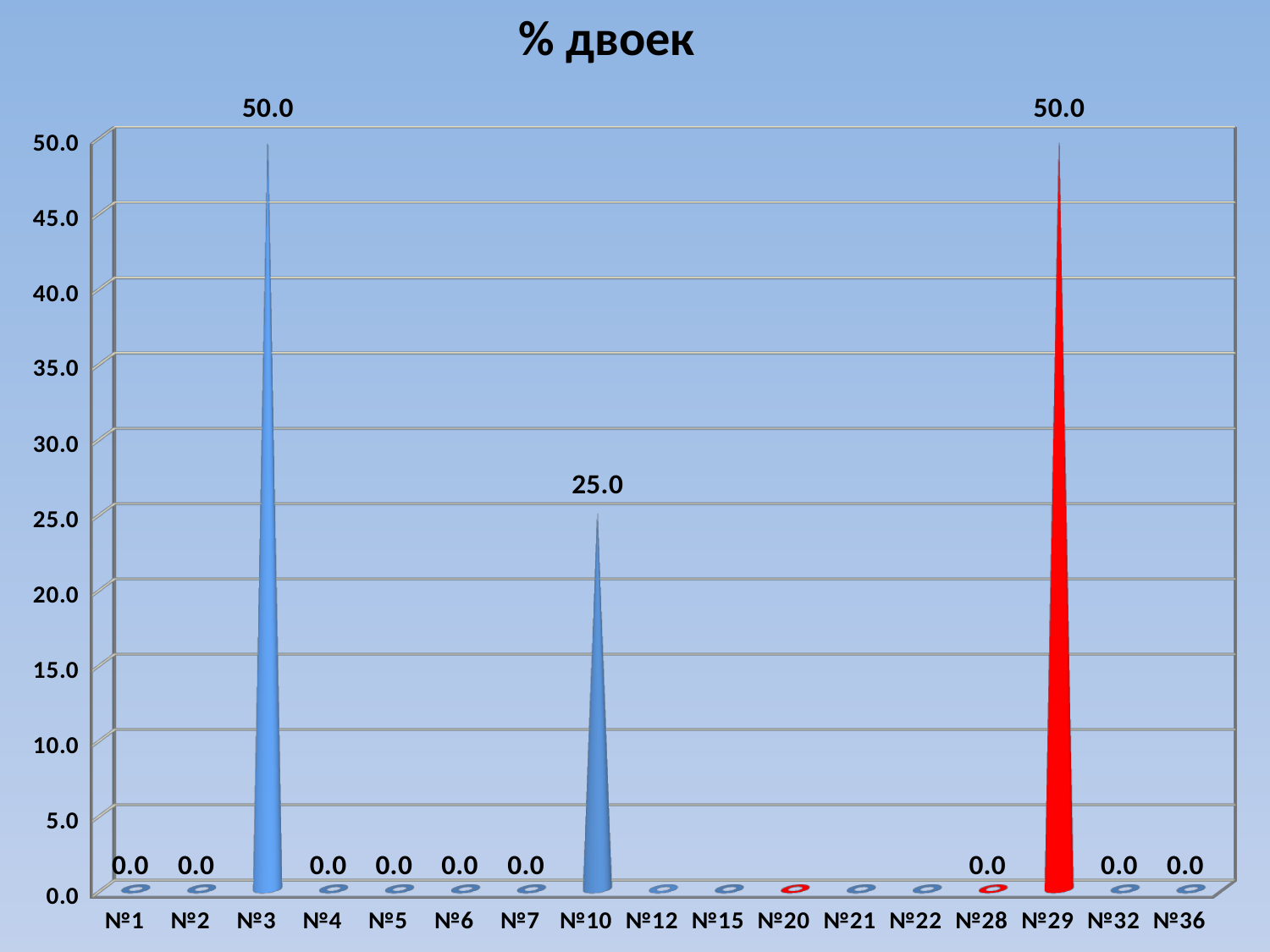
What is the value for №10? 25.0 What kind of chart is this? bar chart What is the value for №29? 50.0 Which two categories share the highest value? №3 and №29 Which has the larger value, №10 or №29? №29 How many categories are shown on the x axis? 17 What is the value for №3? 50.0 What is the value for №28? 0.0 What is the difference between the values for №3 and №10? 25.0 Is the value for №10 greater or less than 30.0? less What is the value for №1? 0.0 What is the title of the chart? % двоек